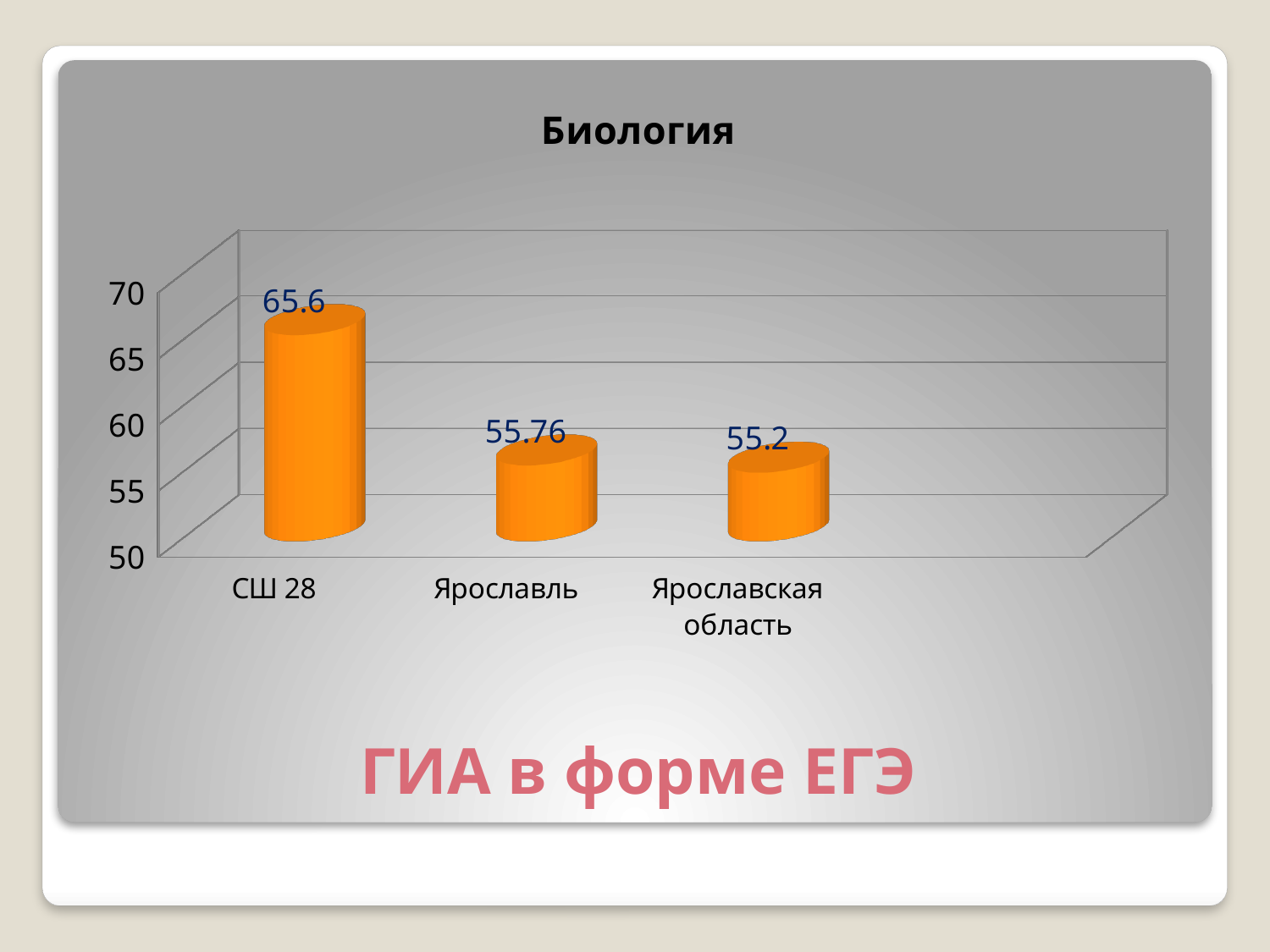
What is the difference between the values for Ярославль and Ярославская область? 0.56 Which category has the lowest value? Ярославская область What kind of chart is shown on the slide? bar chart What is the difference between the values for СШ 28 and Ярославль? 9.84 Which category has the highest value? СШ 28 Which is larger, the value for СШ 28 or the value for Ярославская область? СШ 28 What is the value for СШ 28? 65.6 How many categories are shown on the chart? 3 What is the title of the chart? Биология Is the value for СШ 28 greater or less than 60? greater What is the value for Ярославская область? 55.2 What is the value for Ярославль? 55.76